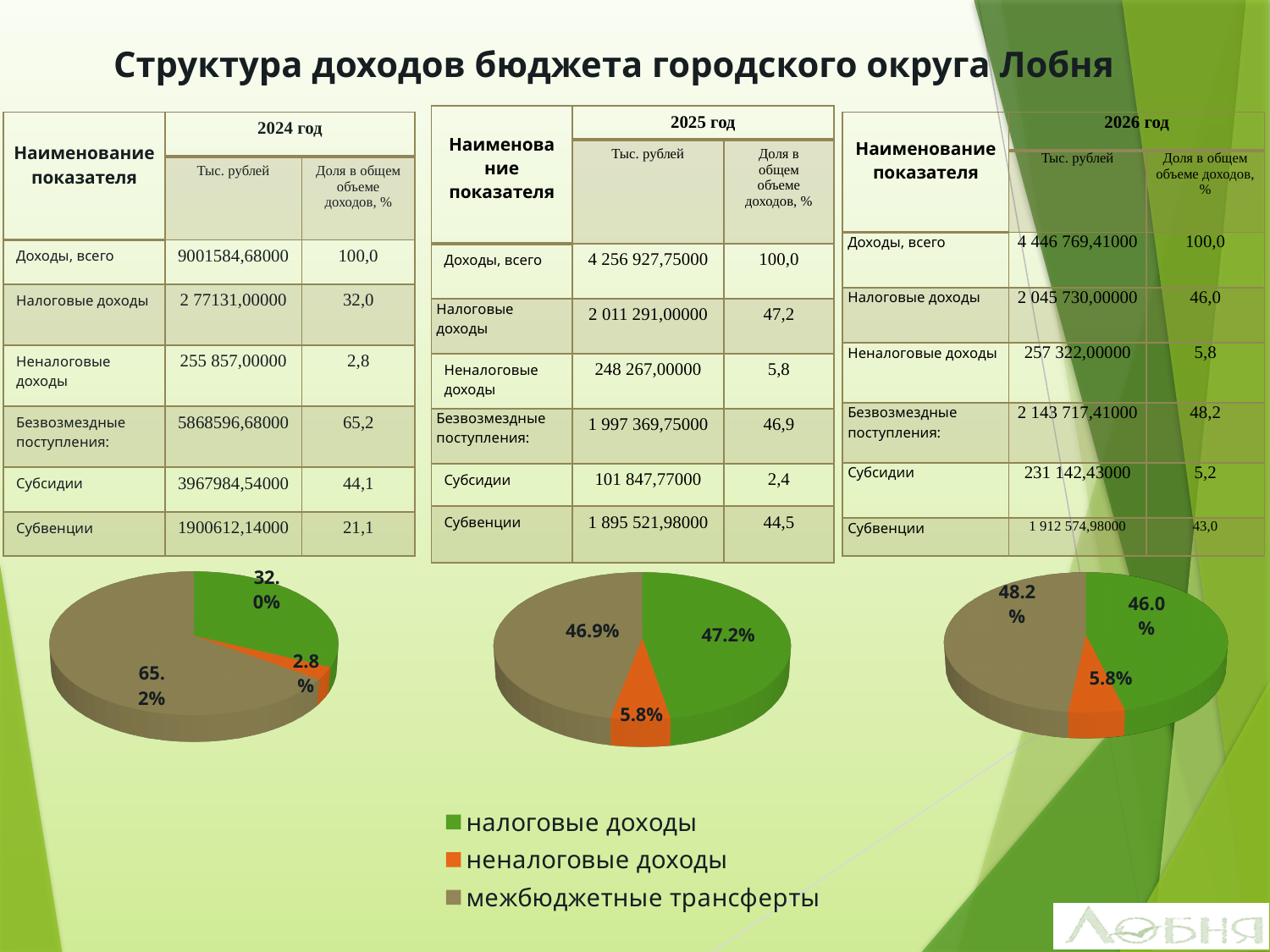
In the right pie chart, what is the difference between the межбюджетные трансферты slice and the налоговые доходы slice? 2.2% In the left pie chart, which category has the largest slice? межбюджетные трансферты In the left pie chart, which is larger: the налоговые доходы slice or the неналоговые доходы slice? налоговые доходы In the middle pie chart, which category has the smallest slice? неналоговые доходы What type of chart is used at the bottom of the slide? Pie chart In the left pie chart, what is the difference between the межбюджетные трансферты slice and the налоговые доходы slice? 33.2% In the right pie chart, what is the share labelled for налоговые доходы (green slice)? 46.0% In the middle pie chart, what is the share labelled for неналоговые доходы (orange slice)? 5.8% In the left pie chart, what is the share labelled for межбюджетные трансферты (brown slice)? 65.2% In the right pie chart, which category has the largest slice? межбюджетные трансферты How many slices does each pie chart have? 3 In the left pie chart, what is the share labelled for налоговые доходы (green slice)? 32.0%